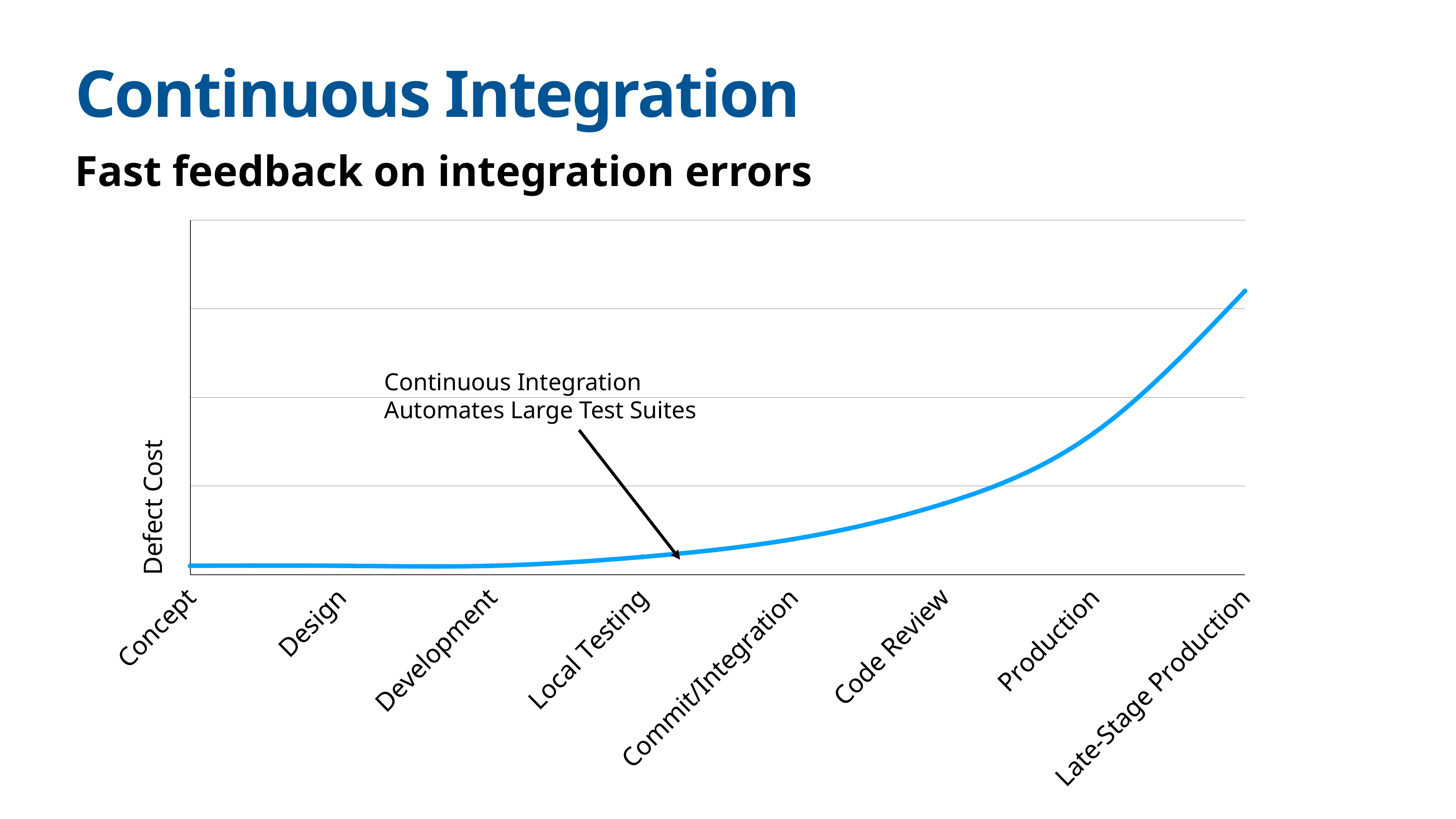
Which has the larger defect cost, Production or Code Review? Production Which has the larger defect cost, Late-Stage Production or Production? Late-Stage Production Which x-axis category does the annotation 'Continuous Integration Automates Large Test Suites' point to? Commit/Integration Which category has the highest defect cost in the chart? Late-Stage Production What kind of chart is shown on the slide? line chart Which has the larger defect cost, Commit/Integration or Production? Production How many categories are shown along the x axis of the chart? 8 What is the first category on the x axis of the chart? Concept Does the defect cost rise or fall as you move from Concept to Late-Stage Production along the x axis? rise What is the label on the y axis of the chart? Defect Cost